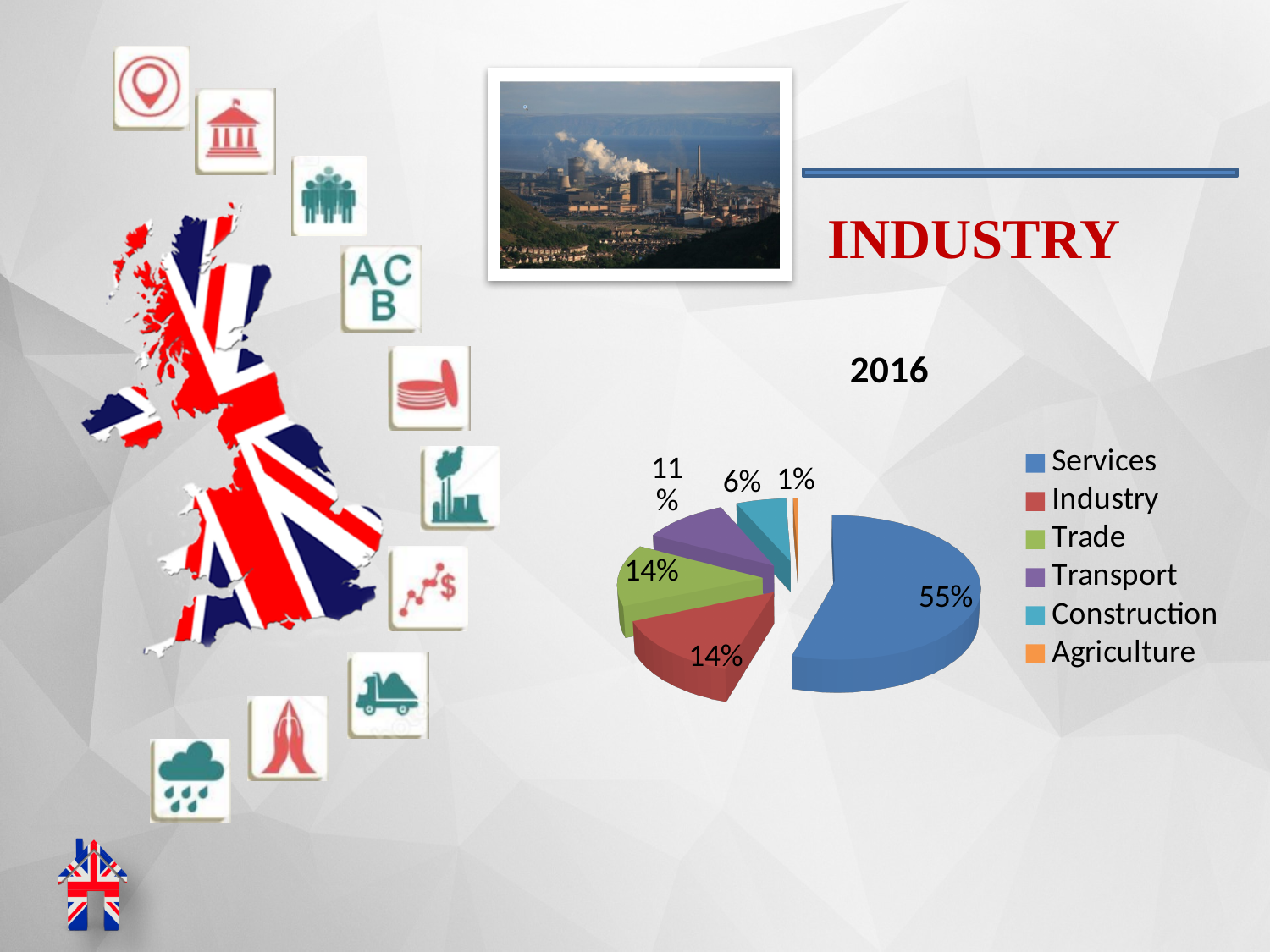
How many categories does the legend of the pie chart list? 6 Which category has the largest slice of the pie? Services Which category has the smallest slice of the pie? Agriculture What kind of chart is shown on the slide? Pie chart What is the difference between the Services share and the Industry share? 41% What share of the pie does Services have? 55% Which colour represents Services in the pie chart? Blue What share of the pie does Agriculture have? 1% What share of the pie does Transport have? 11% What is the title of the pie chart? 2016 Which is larger, the share for Transport or the share for Construction? Transport What share of the pie does Construction have? 6%